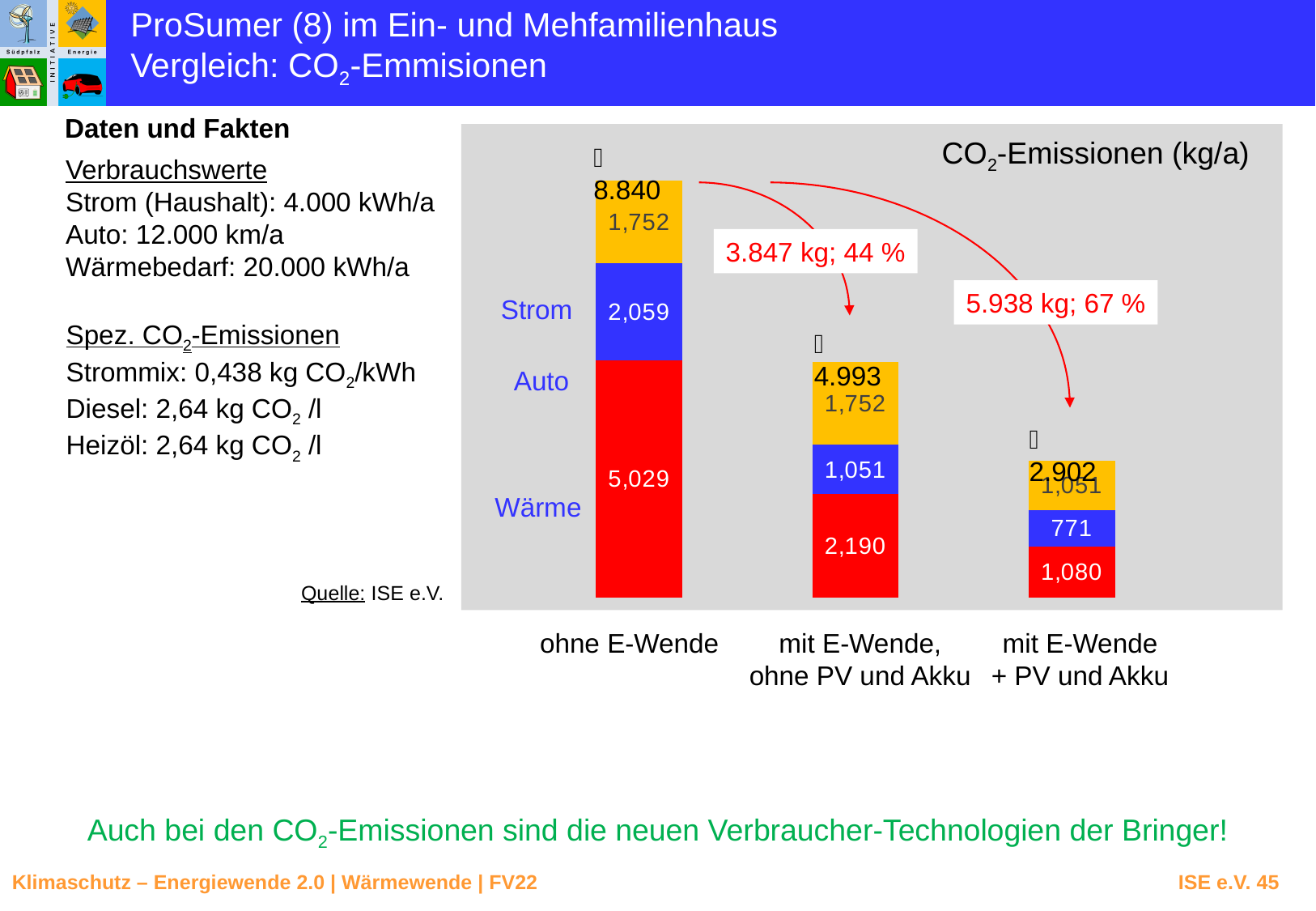
What is the value of the yellow (top) segment in the 'mit E-Wende, ohne PV und Akku' bar? 1,752 What is the total CO2 emission value printed above the 'mit E-Wende + PV und Akku' bar? 2.902 What is the total CO2 emission value printed above the 'mit E-Wende, ohne PV und Akku' bar? 4.993 According to the red annotation, by how much (kg and %) do emissions fall from 'ohne E-Wende' to 'mit E-Wende + PV und Akku'? 5.938 kg; 67 % What is the title shown in the top right of the chart area? CO2-Emissionen (kg/a) What is the value of the blue (middle) segment in the 'mit E-Wende + PV und Akku' bar? 771 What is the total CO2 emission value printed above the 'ohne E-Wende' bar? 8.840 What is the value of the red (bottom) segment in the 'ohne E-Wende' bar? 5,029 Which scenario has the lowest total CO2 emissions? mit E-Wende + PV und Akku Which scenario has the highest total CO2 emissions? ohne E-Wende How many bars (scenarios) are shown in the CO2-Emissionen chart? 3 What type of chart is shown on the slide? stacked bar chart